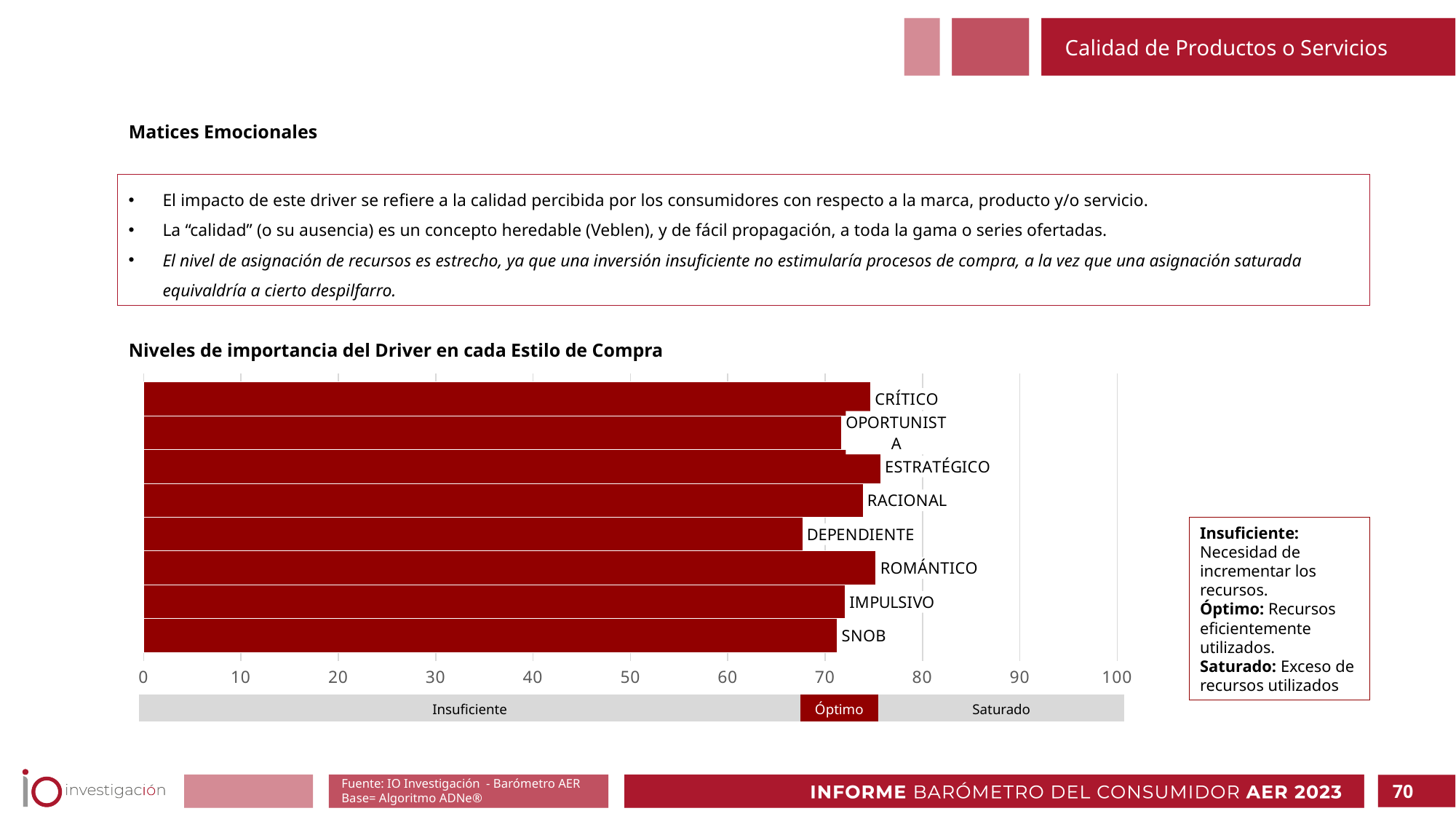
What are the three zone labels shown beneath the x axis of the bar chart? Insuficiente, Óptimo, Saturado Is the value for ROMÁNTICO greater or less than 70? greater How many purchase styles (categories) are plotted in the bar chart? 8 Which has a larger value, ESTRATÉGICO or DEPENDIENTE? ESTRATÉGICO Which has a larger value, DEPENDIENTE or CRÍTICO? CRÍTICO What kind of chart is shown under 'Niveles de importancia del Driver en cada Estilo de Compra'? Bar chart Is the value for CRÍTICO greater or less than 70? greater Is the value for SNOB greater or less than 80? less What is the title of the bar chart on the slide? Niveles de importancia del Driver en cada Estilo de Compra Which purchase style has the lowest value in the bar chart? DEPENDIENTE